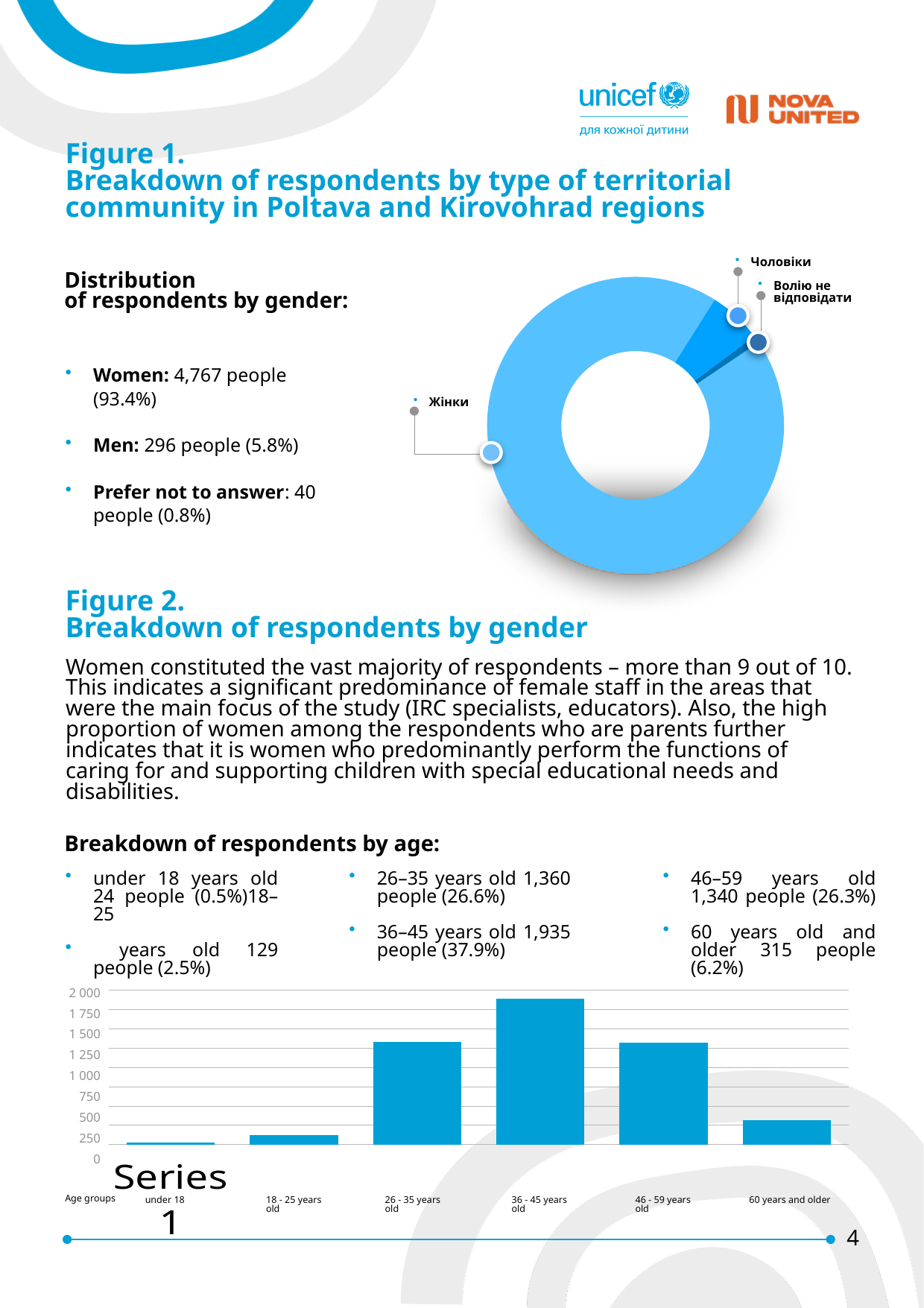
In the bottom bar chart of respondents by age, is the value for 36 - 45 years old greater or less than 1 750? greater In the bottom bar chart of respondents by age, which bar is taller: 18 - 25 years old or 60 years and older? 60 years and older In the bottom bar chart of respondents by age, which age group has the shortest bar? under 18 What kind of chart is the bottom chart showing the breakdown of respondents by age? bar chart In the top doughnut chart of respondents by gender, how many segments are there? 3 What kind of chart is the top chart showing the distribution of respondents by gender? doughnut chart In the bottom bar chart of respondents by age, how many age-group categories are plotted? 6 In the top doughnut chart of respondents by gender, which segment is the largest? Жінки In the bottom bar chart of respondents by age, which age group has the tallest bar? 36 - 45 years old In the bottom bar chart of respondents by age, is the value for 26 - 35 years old greater or less than 1 250? greater